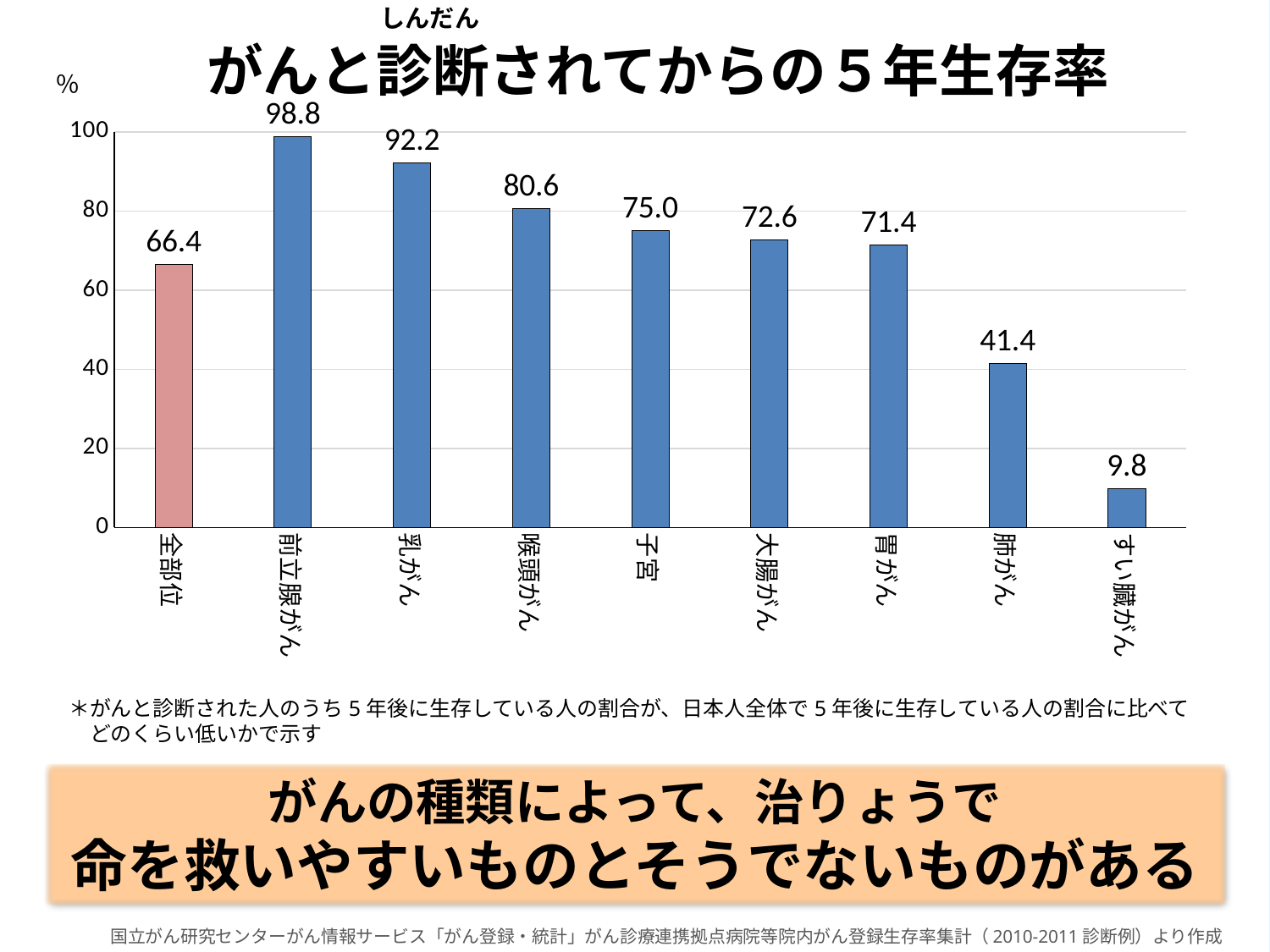
Which is larger, the value for 子宮 or the value for 大腸がん? 子宮 Which category has the highest 5-year survival rate? 前立腺がん What is the 5-year survival rate shown for 前立腺がん? 98.8 What is the value shown for 全部位? 66.4 Which bar is coloured differently (pink) from the others? 全部位 What is the difference between the values for 乳がん and 胃がん? 20.8 What is the title of the chart? がんと診断されてからの５年生存率 Is the value for 喉頭がん greater or less than 80? greater What kind of chart is shown on the slide? bar chart What is the value shown for 肺がん? 41.4 How many categories are shown on the x axis? 9 Which category has the lowest 5-year survival rate? すい臓がん